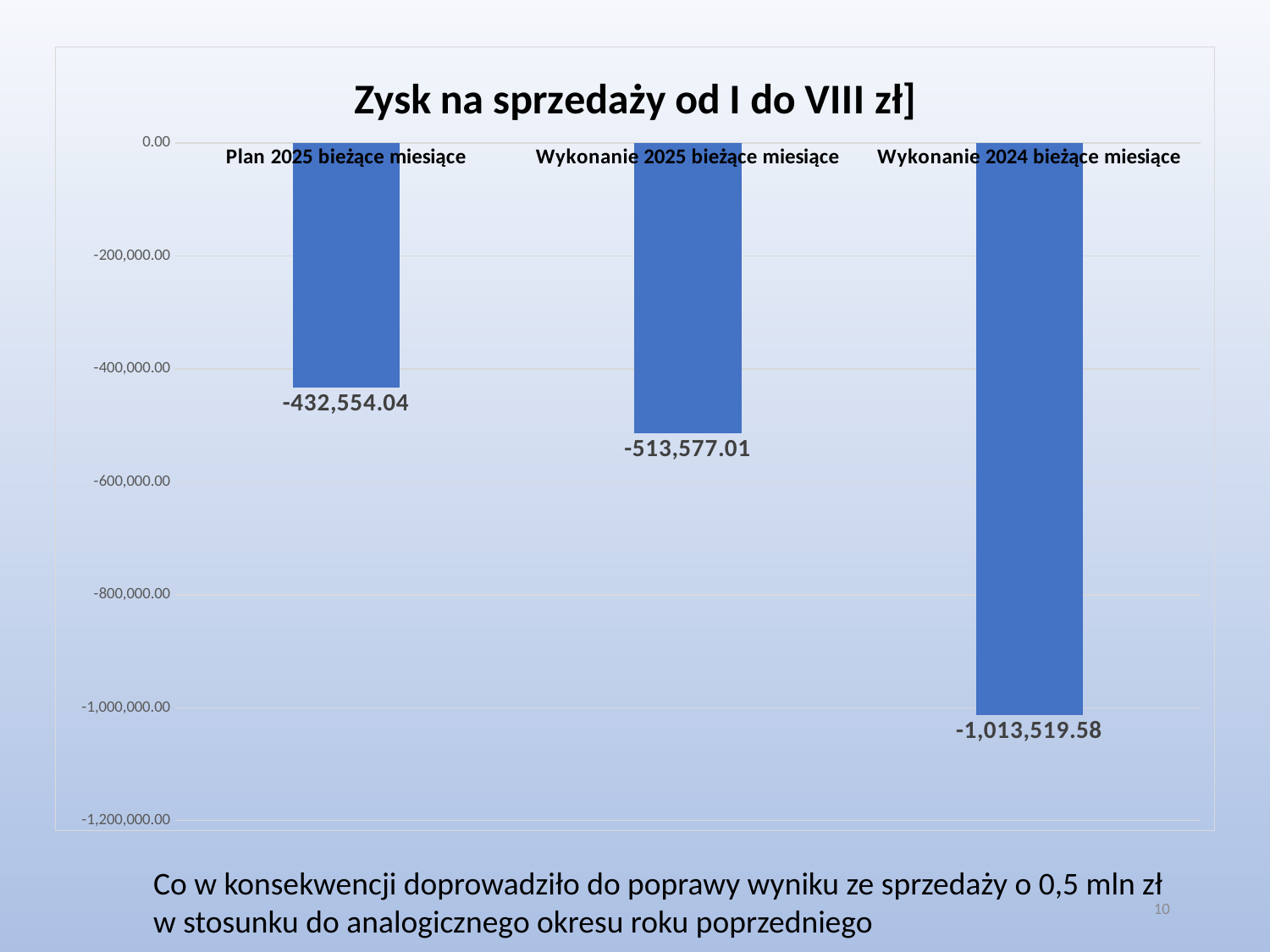
Is the value for Wykonanie 2024 bieżące miesiące greater or less than -800,000.00? less What is the value for Plan 2025 bieżące miesiące? -432,554.04 Which category has the highest value? Plan 2025 bieżące miesiące What is the difference between the values for Plan 2025 bieżące miesiące and Wykonanie 2025 bieżące miesiące? 81,022.97 What is the difference between the values for Wykonanie 2025 bieżące miesiące and Wykonanie 2024 bieżące miesiące? 499,942.57 What kind of chart is shown on the slide? bar chart What is the value for Wykonanie 2024 bieżące miesiące? -1,013,519.58 What is the title of the chart? Zysk na sprzedaży od I do VIII zł] What is the value for Wykonanie 2025 bieżące miesiące? -513,577.01 Which is larger, the value for Plan 2025 bieżące miesiące or Wykonanie 2025 bieżące miesiące? Plan 2025 bieżące miesiące Which category has the lowest value? Wykonanie 2024 bieżące miesiące How many categories are shown in the chart? 3